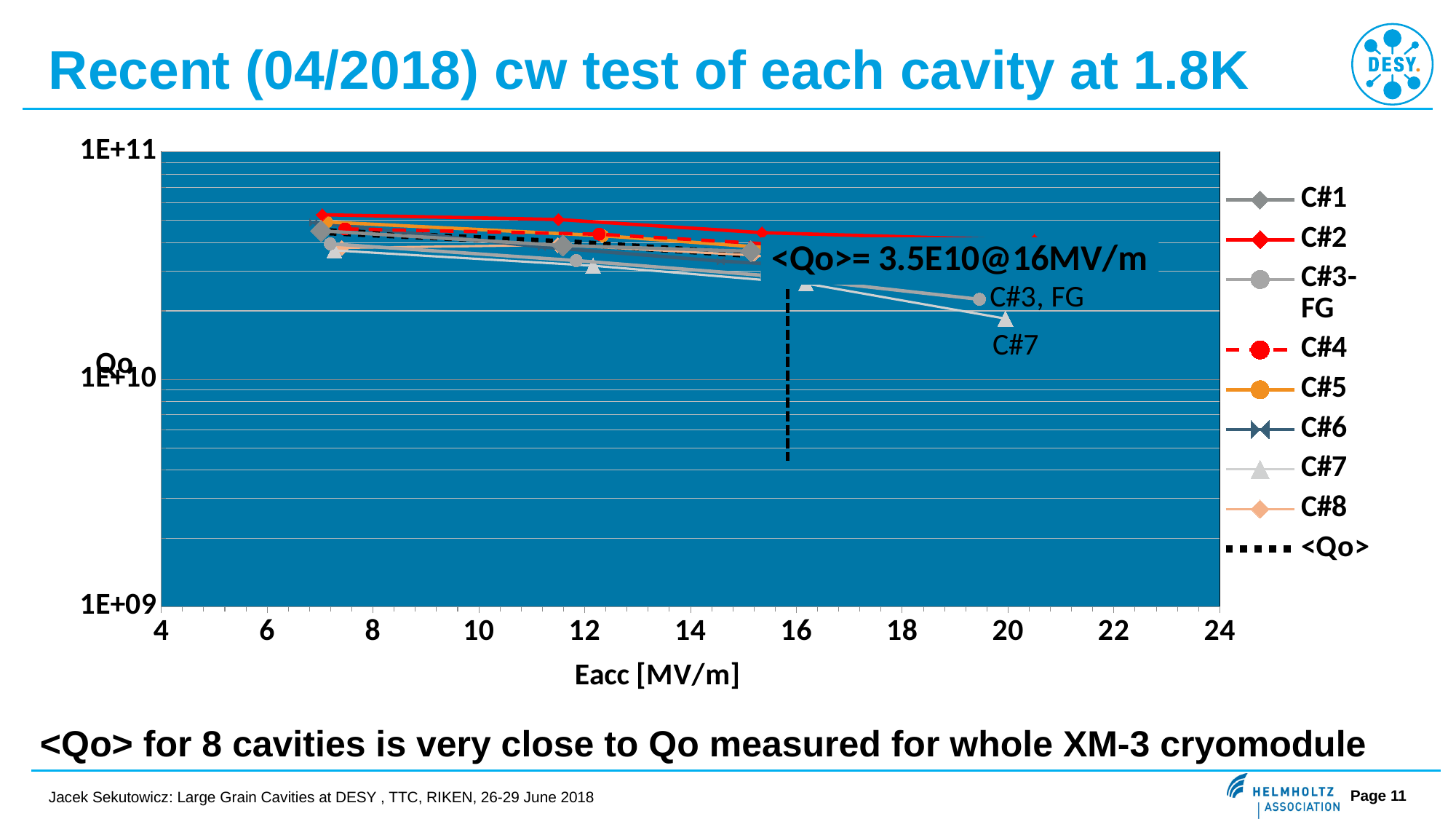
Do the Qo values of the cavities rise or fall as Eacc increases? fall Is the Qo value for C#2 at about 7 MV/m greater or less than 1E+11? less Is the Qo value for C#7 at about 20 MV/m greater or less than 1E+10? greater What is the lowest tick value shown on the y axis of the chart? 1E+09 What is the label of the x axis of the chart? Eacc [MV/m] What kind of chart is shown on the slide? line chart Which cavity series has the highest Qo values across the plotted Eacc range? C#2 Which cavity series has the lowest Qo value at its highest plotted Eacc (around 20 MV/m)? C#7 According to the annotation on the chart, what is the value of <Qo> at 16 MV/m? 3.5E10 How many series does the chart legend list? 9 What is the highest tick value shown on the x axis of the chart? 24 At about 20 MV/m, which series has the larger Qo: C#3, FG or C#7? C#3, FG